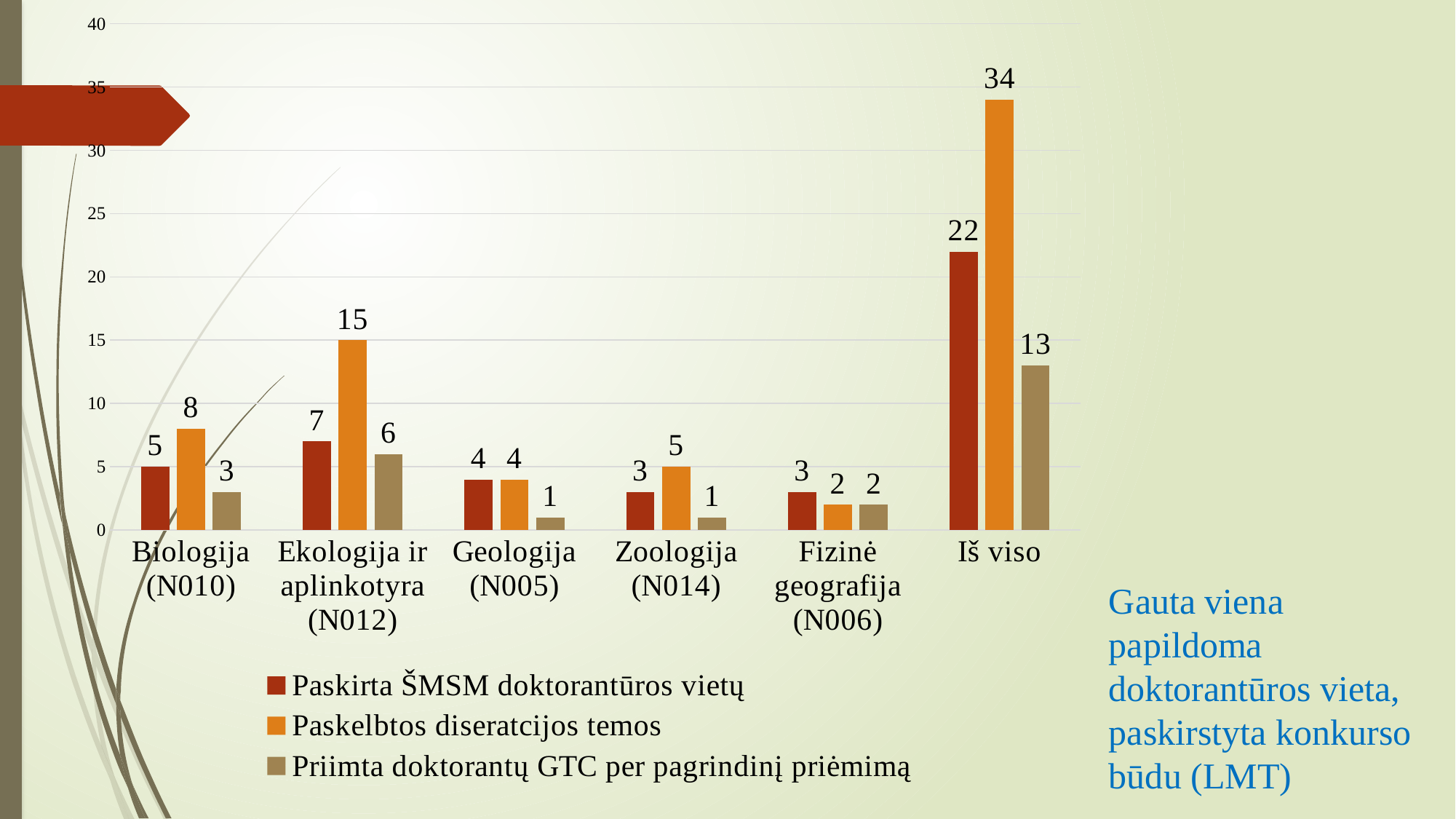
What is the value of "Paskelbtos diseratcijos temos" for Ekologija ir aplinkotyra (N012)? 15 How many categories are shown on the x axis? 6 What is the difference between "Paskelbtos diseratcijos temos" and "Paskirta ŠMSM doktorantūros vietų" for Iš viso? 12 Excluding Iš viso, which category has the lowest value for "Priimta doktorantų GTC per pagrindinį priėmimą"? Geologija (N005) and Zoologija (N014) How many series does the legend list? 3 What is the value of "Paskirta ŠMSM doktorantūros vietų" for Iš viso? 22 Which is larger for Fizinė geografija (N006): "Paskirta ŠMSM doktorantūros vietų" or "Paskelbtos diseratcijos temos"? Paskirta ŠMSM doktorantūros vietų What kind of chart is shown on the slide? Bar chart What is the value of "Priimta doktorantų GTC per pagrindinį priėmimą" for Biologija (N010)? 3 What colour are the bars for "Paskelbtos diseratcijos temos"? Orange Which category has the highest value for "Paskelbtos diseratcijos temos"? Iš viso What is the value of "Paskelbtos diseratcijos temos" for Zoologija (N014)? 5